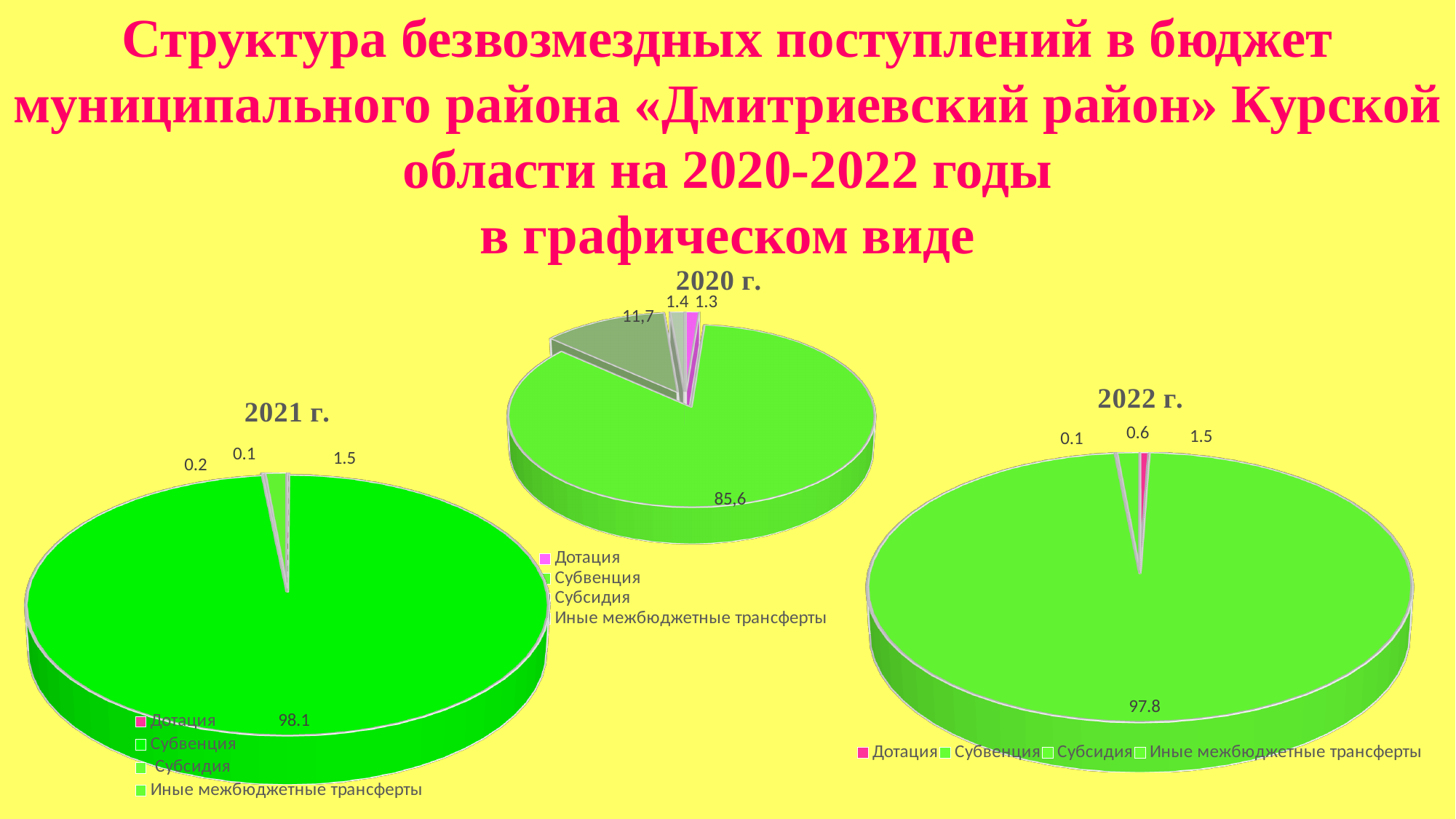
In the 2020 г. chart, which is larger: the slice labelled 11,7 or the slice labelled 1.4? 11,7 In the 2022 г. chart, what is the value of the largest slice? 97.8 What is the difference between the largest slice in the 2021 г. chart (98.1) and the largest slice in the 2022 г. chart (97.8)? 0.3 What kind of charts are shown on the slide? Pie charts In the 2021 г. chart, what is the value of the largest slice? 98.1 In the 2020 г. chart, what is the value of the largest slice? 85,6 Which chart has the larger value for its biggest slice, 2020 г. or 2021 г.? 2021 г. How many pie charts are on the slide? 3 How many entries does the legend of the 2020 г. chart list? 4 In the 2022 г. chart, what is the smallest labelled value? 0.1 In the 2021 г. chart, what is the smallest labelled value? 0.1 Which legend category does the largest slice in the 2022 г. chart belong to? Субвенция